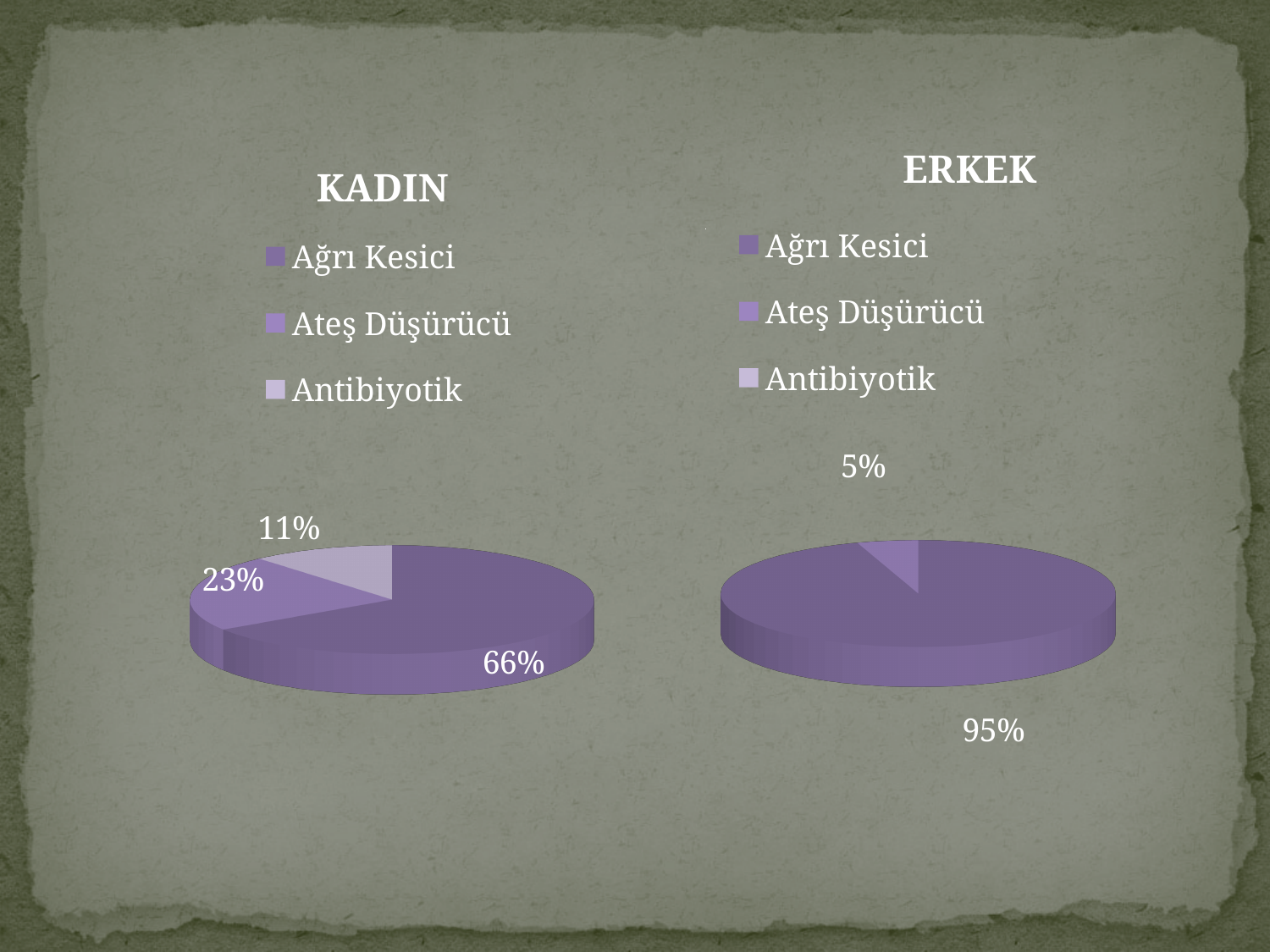
Which chart shows a larger share for Ağrı Kesici, KADIN or ERKEK? ERKEK In the KADIN chart, what share does Ateş Düşürücü have? 23% In the KADIN chart, which category has the smallest slice? Antibiyotik What type of chart is the KADIN chart? Pie chart How many slices are labelled with percentages in the KADIN chart? 3 In the KADIN chart, what share does Ağrı Kesici have? 66% How many entries does the legend of the ERKEK chart list? 3 In the KADIN chart, what is the difference between the Ağrı Kesici and Ateş Düşürücü shares? 43% In the ERKEK chart, what is the difference between the largest and smallest labelled slices? 90% In the KADIN chart, which category has the largest slice? Ağrı Kesici In the ERKEK chart, what share does Ağrı Kesici have? 95% In the KADIN chart, what share does Antibiyotik have? 11%